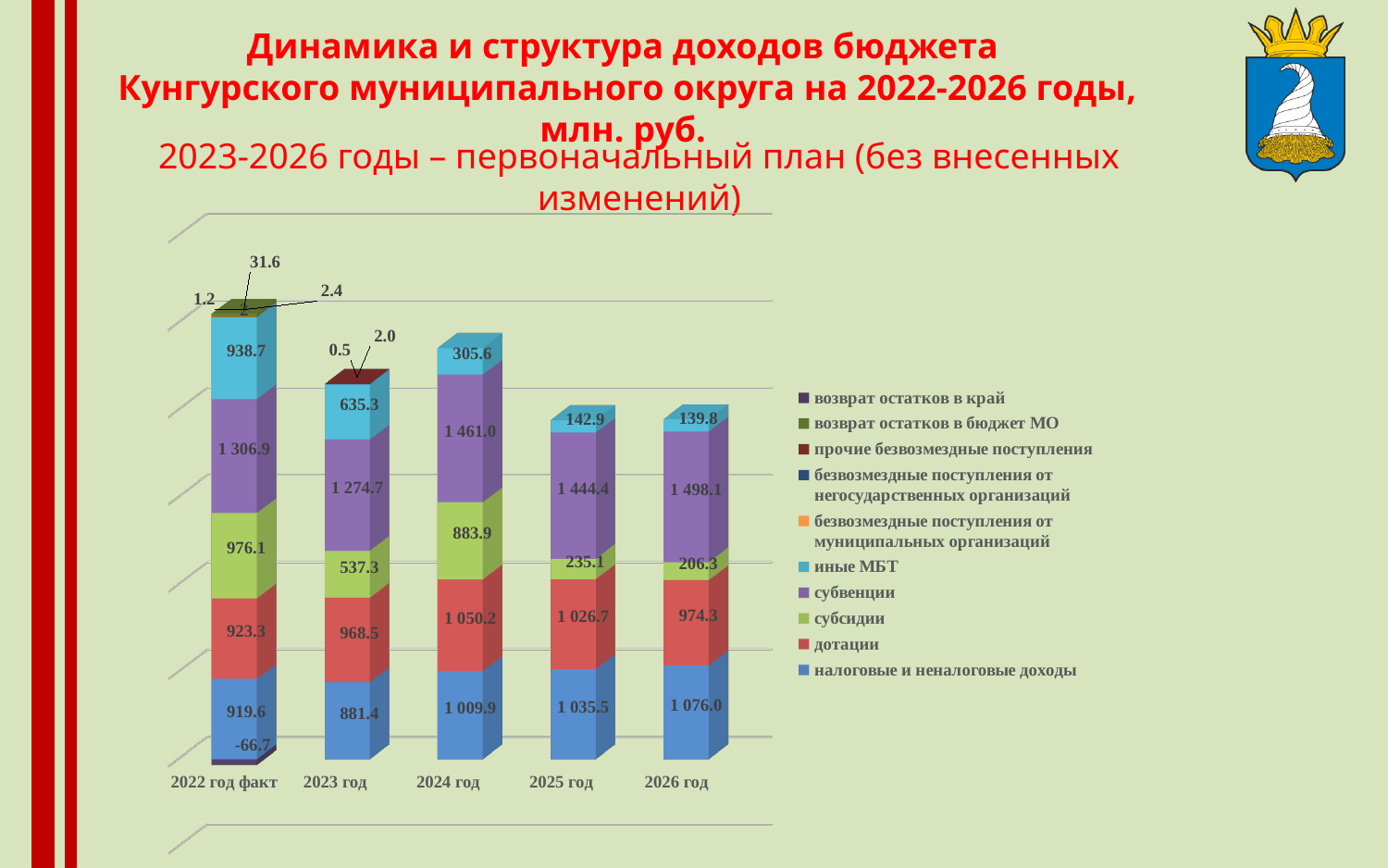
How many series does the legend list? 10 What is the difference between субвенции in 2026 год and 2025 год? 53.7 In which year is the value of субвенции the highest? 2026 год What kind of chart is shown on the slide? stacked bar chart What is the value of дотации for 2023 год? 968.5 Which is larger: дотации in 2024 год or дотации in 2025 год? 2024 год Do the values of налоговые и неналоговые доходы rise or fall from 2023 год to 2026 год? rise In which year is the value of субсидии the lowest? 2026 год What is the value of налоговые и неналоговые доходы for 2026 год? 1 076.0 How many years (categories) are shown on the x axis? 5 What is the value of иные МБТ for 2022 год факт? 938.7 What is the value of субвенции for 2024 год? 1 461.0